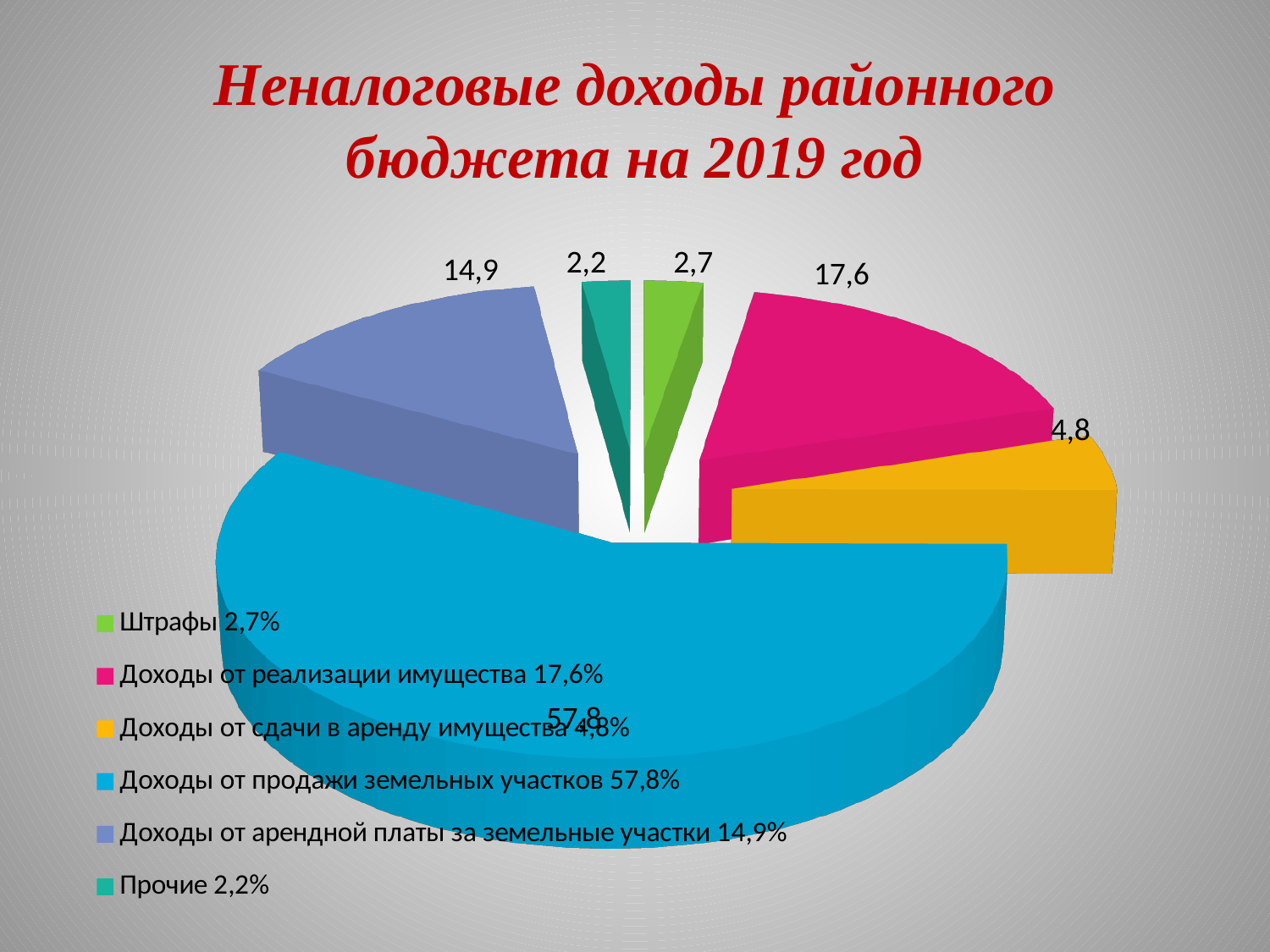
Which category has the largest slice of the pie? Доходы от продажи земельных участков How many slices does the pie chart have? 6 What type of chart is shown on the slide? pie chart Which is larger: Доходы от реализации имущества or Доходы от арендной платы за земельные участки? Доходы от реализации имущества What is the value for Доходы от арендной платы за земельные участки? 14,9 What is the title of the chart on the slide? Неналоговые доходы районного бюджета на 2019 год What is the value for Доходы от сдачи в аренду имущества? 4,8 What is the value for Доходы от продажи земельных участков? 57,8 What is the difference between the values for Доходы от продажи земельных участков and Доходы от реализации имущества? 40,2 What is the value for Штрафы? 2,7 Which category has the smallest slice of the pie? Прочие What is the value for Доходы от реализации имущества? 17,6